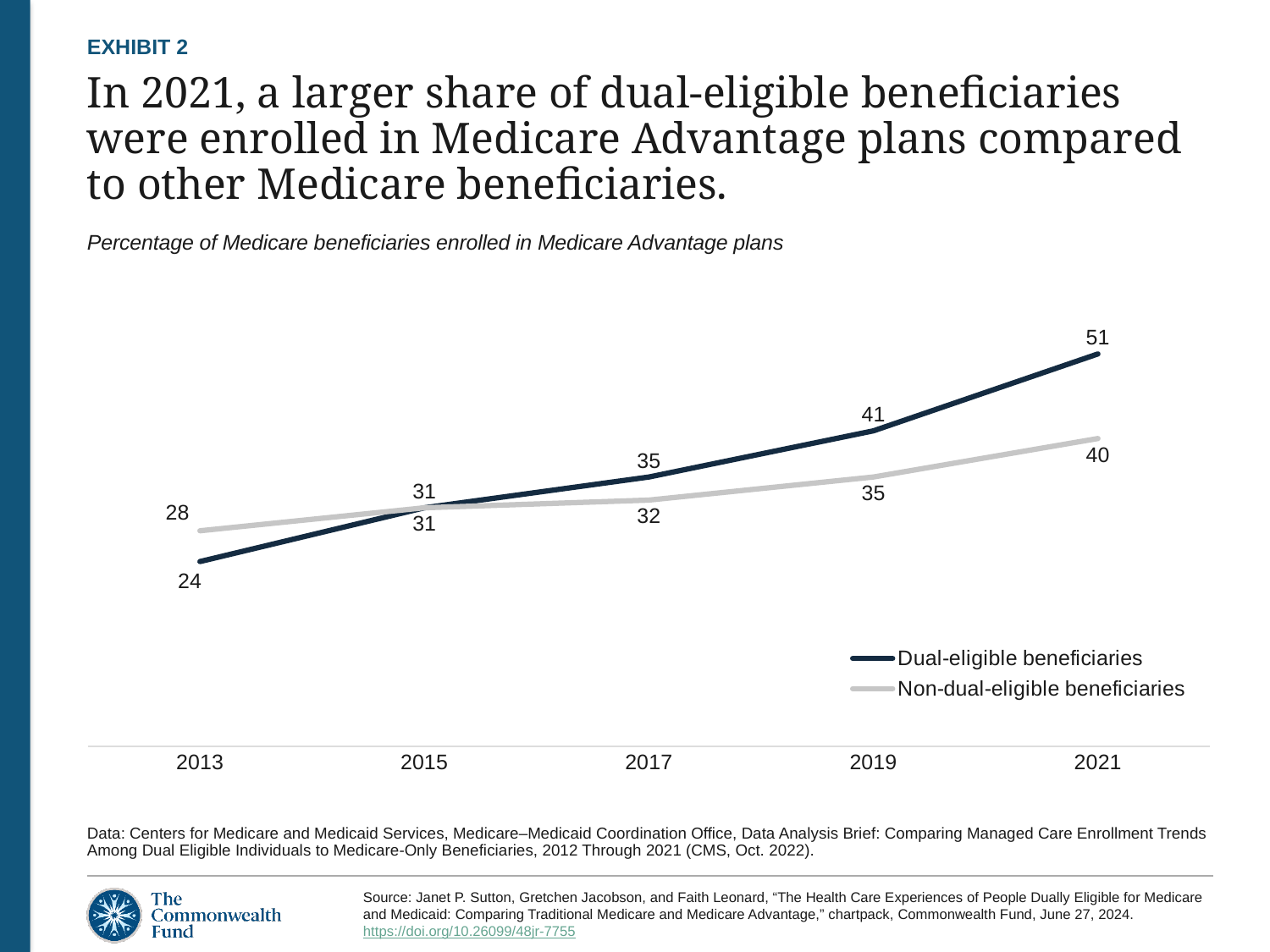
In which year is the value for Dual-eligible beneficiaries highest? 2021 How many series does the legend list? 2 What is the value for Non-dual-eligible beneficiaries in 2013? 28 What kind of chart is shown on the slide? Line chart Which series has the larger value in 2013, Dual-eligible or Non-dual-eligible beneficiaries? Non-dual-eligible beneficiaries What is the difference between Dual-eligible and Non-dual-eligible beneficiaries in 2021? 11 How many years are shown on the x axis? 5 In which year is the value for Dual-eligible beneficiaries lowest? 2013 Do the values for Dual-eligible beneficiaries rise or fall from 2013 to 2021? Rise What is the value for Dual-eligible beneficiaries in 2017? 35 What is the value for Dual-eligible beneficiaries in 2021? 51 What is the value for Non-dual-eligible beneficiaries in 2019? 35